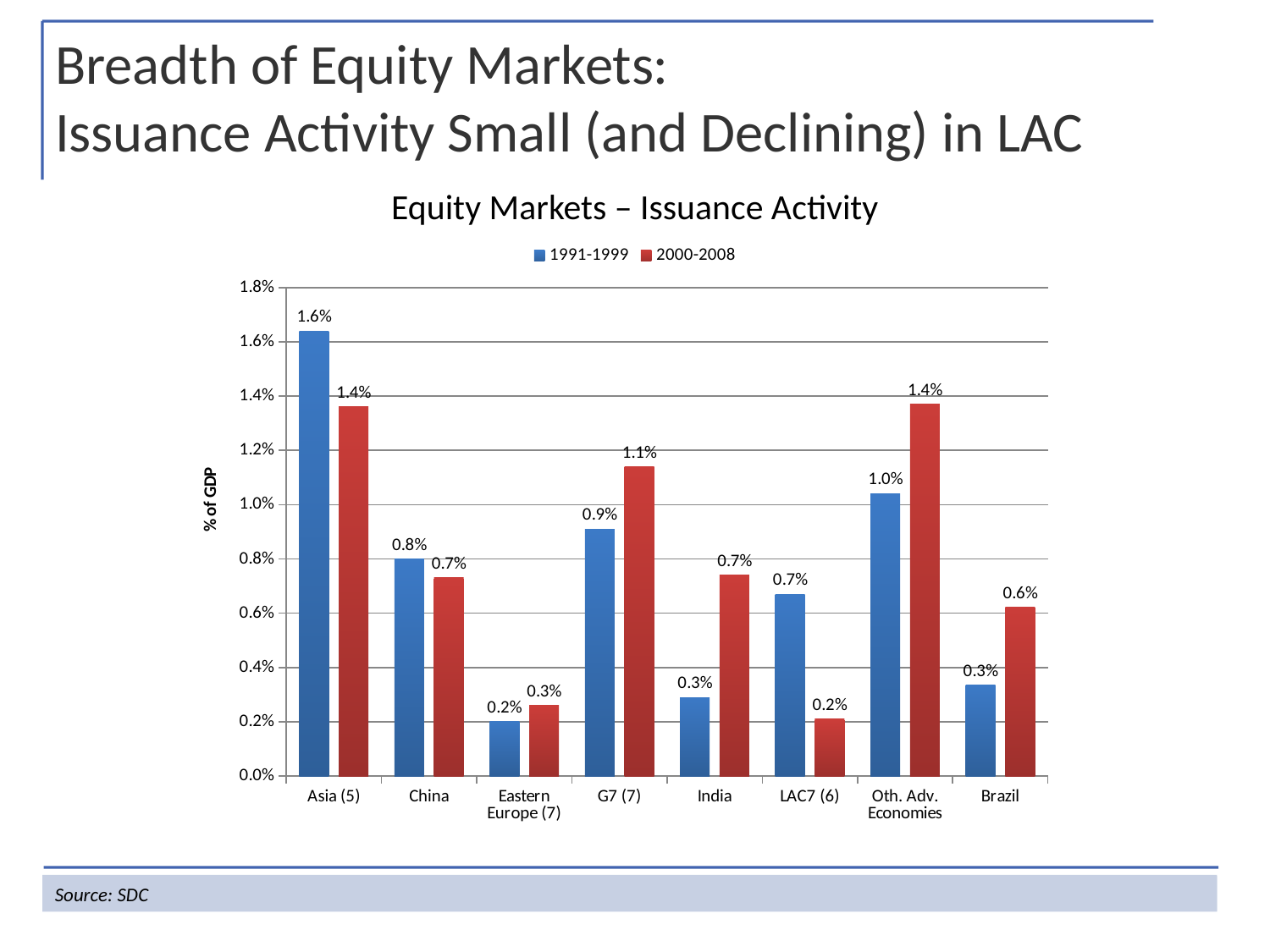
How many categories are shown on the x axis? 8 What is the label on the y axis of the chart? % of GDP Which category has the highest value in the 1991-1999 series? Asia (5) What kind of chart is shown on the slide? bar chart How many series does the legend list? 2 What is the value for Asia (5) in the 1991-1999 series? 1.6% What is the difference between the 1991-1999 and 2000-2008 values for LAC7 (6)? 0.5% For India, which series has the larger value, 1991-1999 or 2000-2008? 2000-2008 Which category has the lowest value in the 2000-2008 series? LAC7 (6) Is the 1991-1999 value for Oth. Adv. Economies greater or less than 0.8%? greater What is the value for LAC7 (6) in the 2000-2008 series? 0.2% What is the value for G7 (7) in the 2000-2008 series? 1.1%